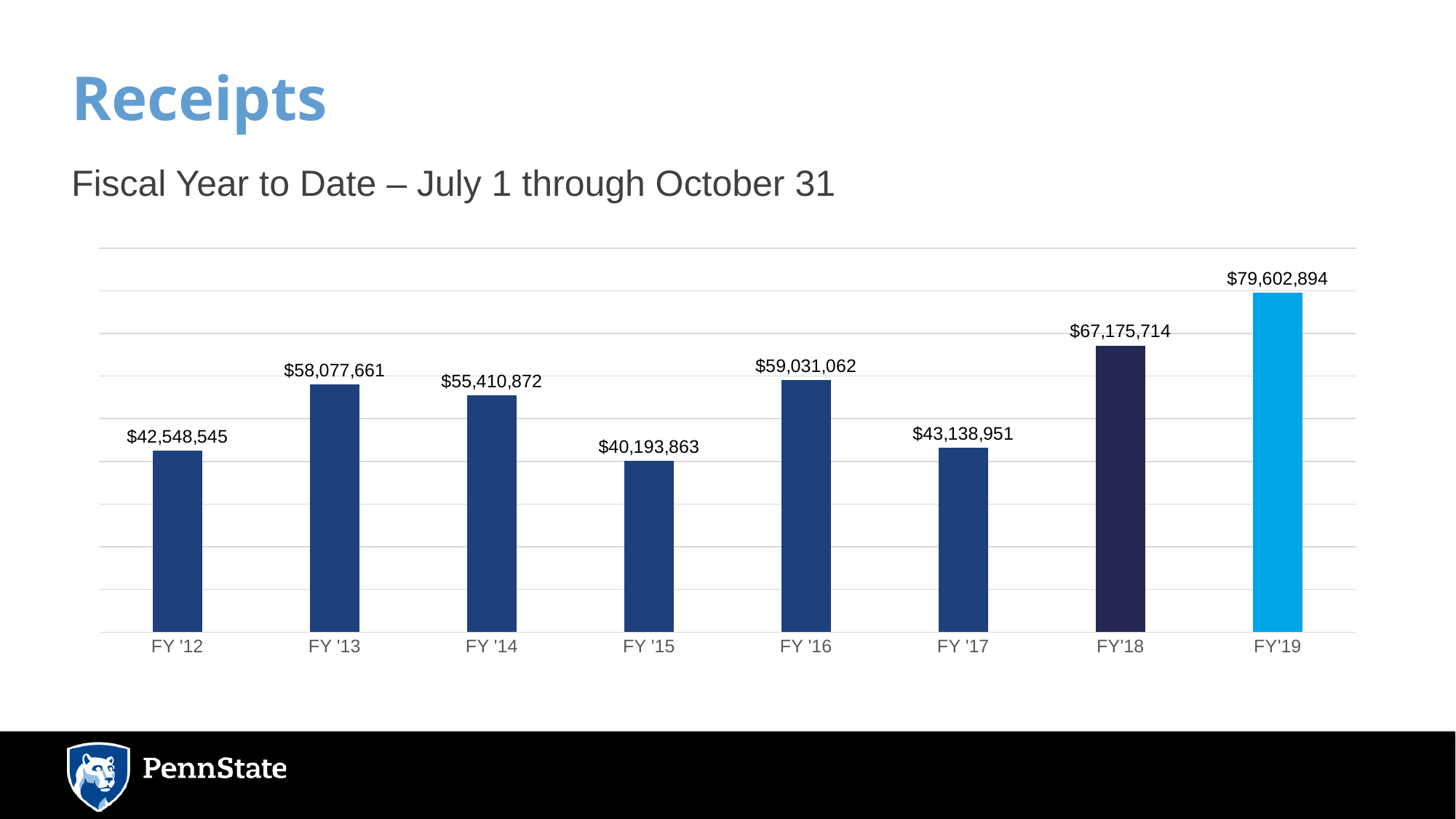
What is the difference between the FY '13 and FY '12 values? $15,529,116 Which is larger, the value for FY '14 or the value for FY '16? FY '16 Which fiscal year has the highest receipts? FY'19 What is the value shown for FY'18? $67,175,714 What is the difference between the FY'19 and FY'18 values? $12,427,180 Which is larger, the value for FY '17 or the value for FY '12? FY '17 Do the values rise or fall from FY '17 to FY'19? Rise Which fiscal year has the lowest receipts? FY '15 What is the value shown for FY '12? $42,548,545 How many fiscal years are shown on the chart? 8 What kind of chart is shown on the slide? Bar chart What is the value shown for FY '15? $40,193,863